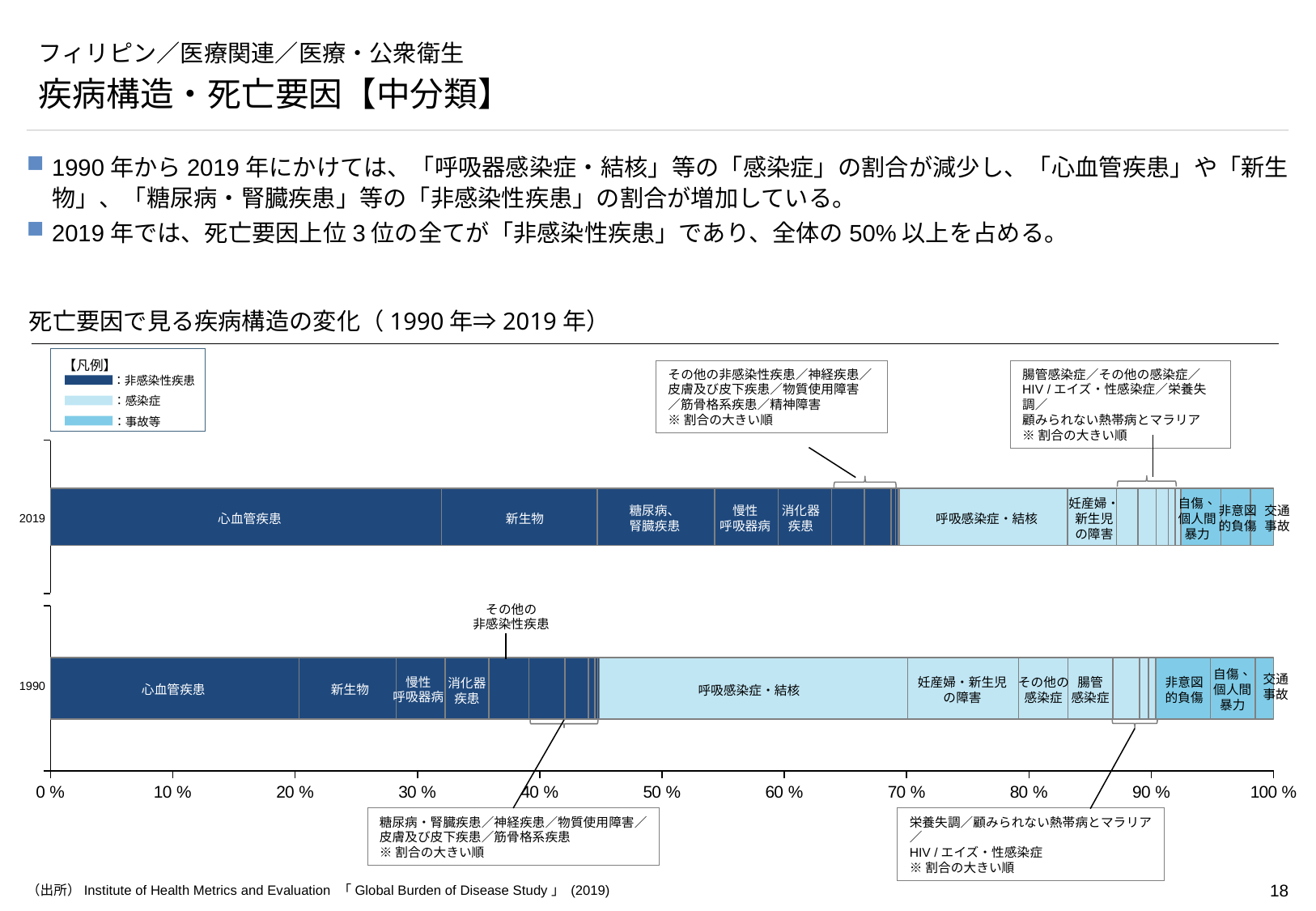
Is the share of 新生物 in 1990 greater or less than 10%? less Is the share of 呼吸器感染症・結核 in 1990 greater or less than 20%? greater Is the share of 呼吸器感染症・結核 larger in 1990 or in 2019? 1990 Which legend category is shown in the darkest blue? 非感染性疾患 What kind of chart is shown on the slide? Stacked bar chart Is the share of 心血管疾患 larger in 2019 or in 1990? 2019 How many years (bars) does the chart compare? 2 How many categories does the legend (凡例) list? 3 Which segment is the largest in the 1990 bar? 呼吸感染症・結核 Which segment is the largest in the 2019 bar? 心血管疾患 Is the share of 心血管疾患 in 1990 greater or less than 30%? less